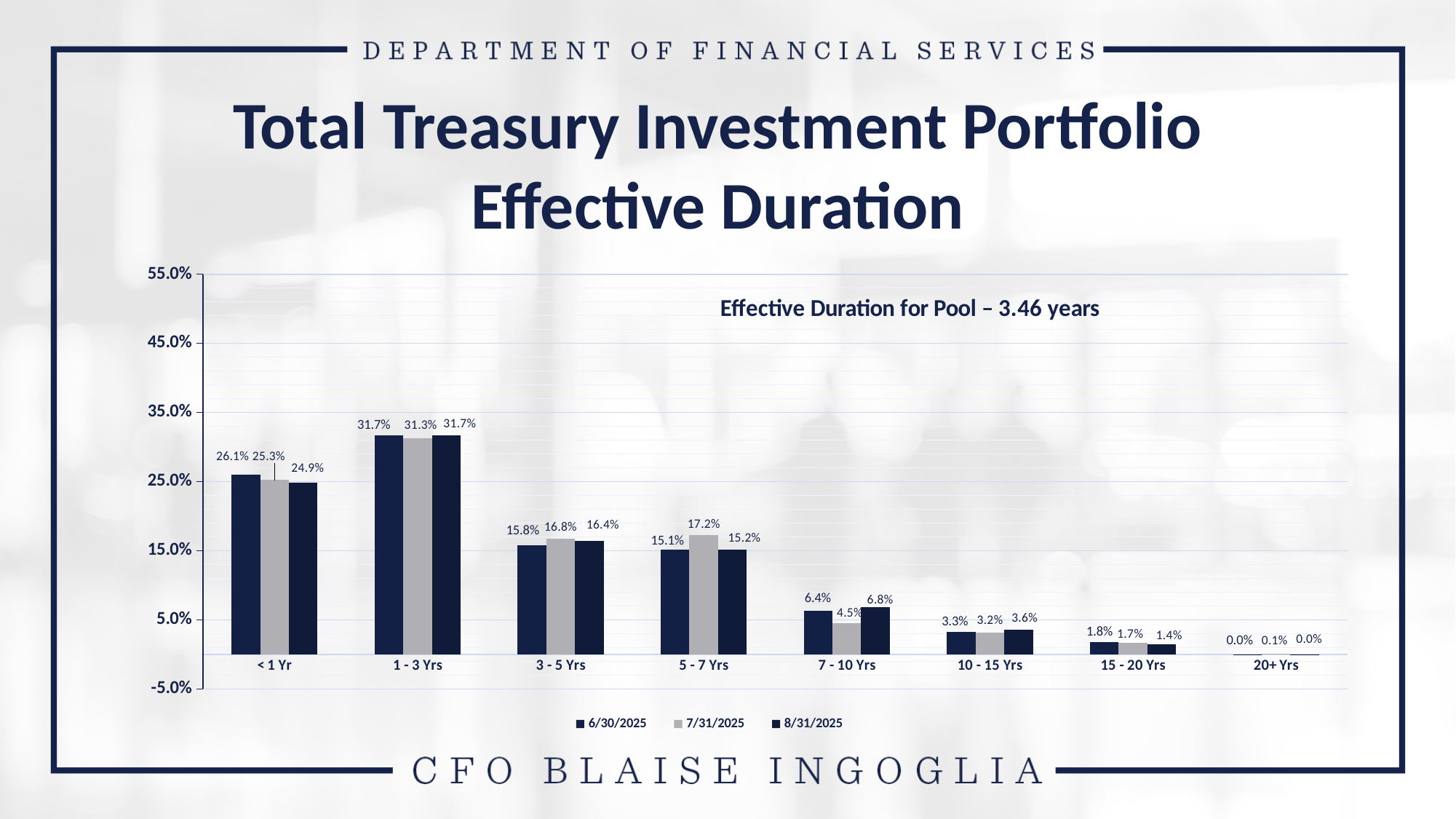
Do the 8/31/2025 values rise or fall from the 1 - 3 Yrs category to the 20+ Yrs category? Fall What is the value for the 1 - 3 Yrs category in the 7/31/2025 series? 31.3% Which is larger for the 7 - 10 Yrs category: the 6/30/2025 value or the 7/31/2025 value? 6/30/2025 What is the difference between the 6/30/2025 and 8/31/2025 values for the < 1 Yr category? 1.2% How many series does the legend list? 3 What is the value for the < 1 Yr category in the 8/31/2025 series? 24.9% Which category has the highest value in the 6/30/2025 series? 1 - 3 Yrs What is the effective duration for the pool stated on the chart? 3.46 years What is the value for the 5 - 7 Yrs category in the 7/31/2025 series? 17.2% What kind of chart is shown on the slide? Bar chart Which category has the lowest value in the 8/31/2025 series? 20+ Yrs How many maturity categories are shown on the x axis? 8